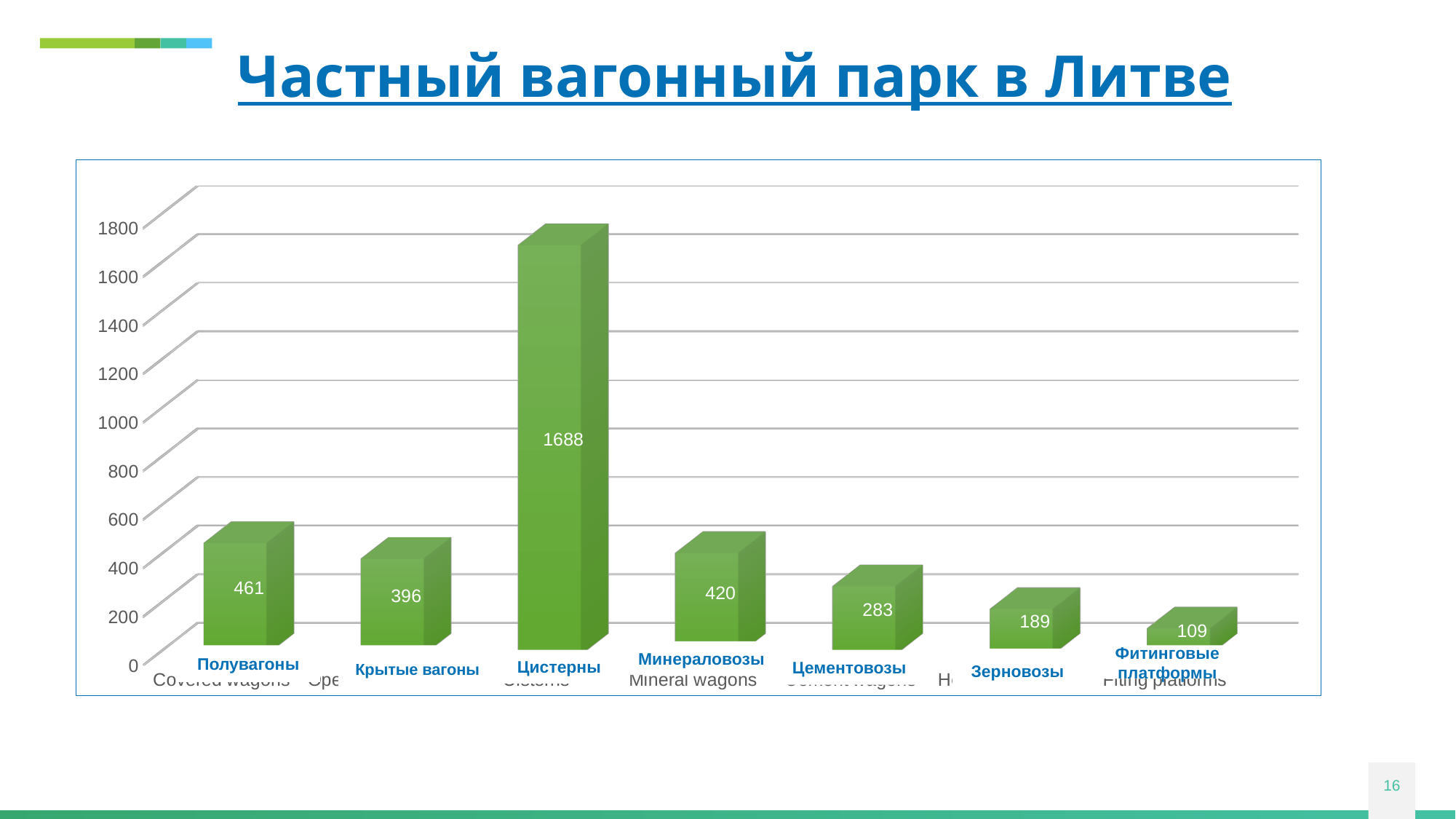
What is the value for Фитинговые платформы? 109 What is the value for Цементовозы? 283 What is the value for Полувагоны? 461 Which category has the highest value? Цистерны What is the value for Цистерны? 1688 What is the title of the slide? Частный вагонный парк в Литве What is the difference between the values for Полувагоны and Крытые вагоны? 65 Which is larger, the value for Минераловозы or the value for Зерновозы? Минераловозы What kind of chart is shown on the slide? bar chart Which category has the lowest value? Фитинговые платформы How many categories are shown in the chart? 7 Is the value for Цистерны greater or less than 1600? greater